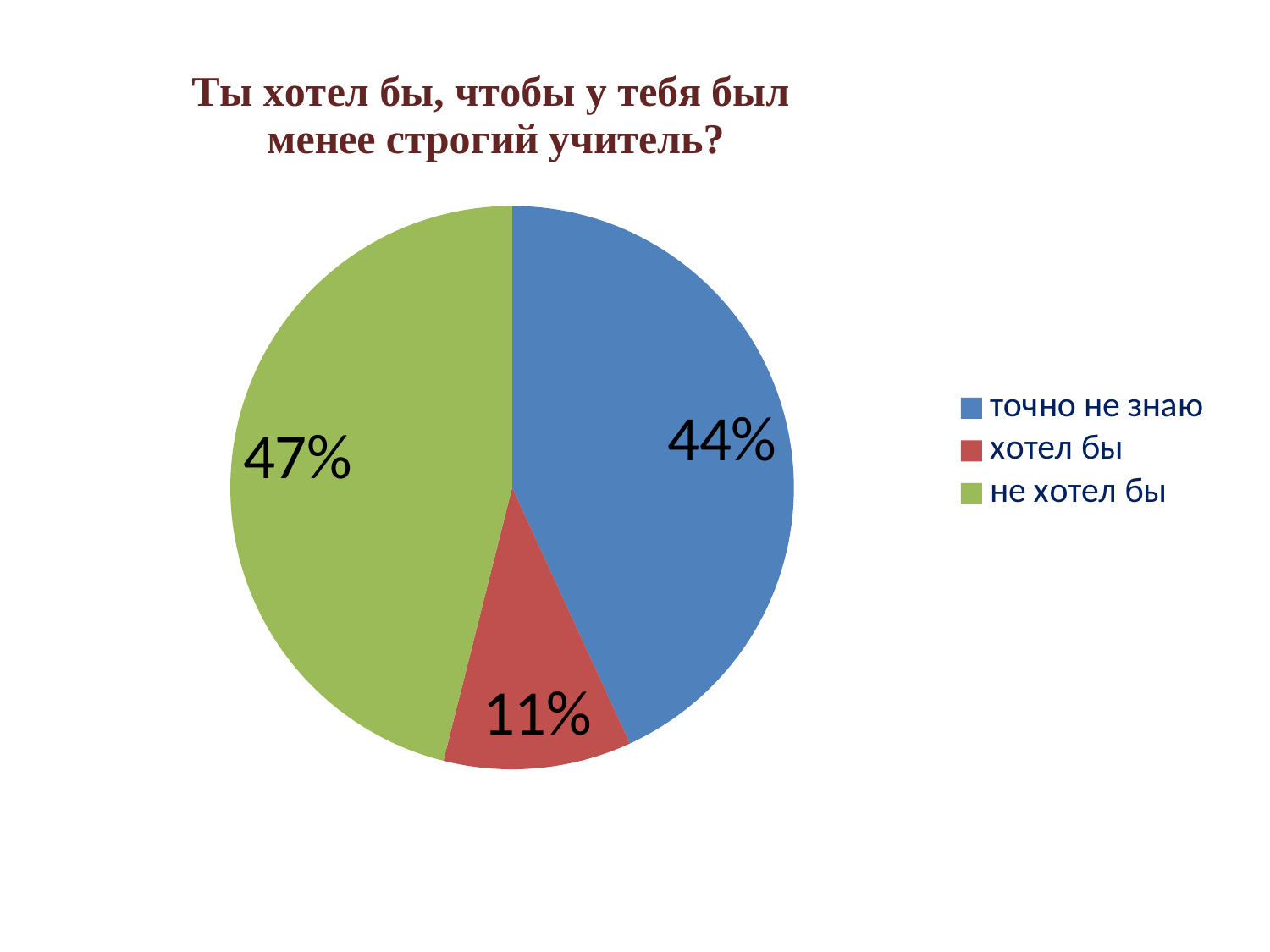
How many slices does the pie chart have? 3 What is the difference in percentage points between "точно не знаю" and "хотел бы"? 33 What share of the pie does "точно не знаю" take? 44% What is the title of the chart? Ты хотел бы, чтобы у тебя был менее строгий учитель? What share of the pie does "не хотел бы" take? 47% What share of the pie does "хотел бы" take? 11% What colour is the slice for "хотел бы"? red Which category has the largest slice of the pie? не хотел бы What is the difference in percentage points between "не хотел бы" and "хотел бы"? 36 Which is larger: the slice for "точно не знаю" or the slice for "хотел бы"? точно не знаю What kind of chart is shown on the slide? pie chart Which category has the smallest slice of the pie? хотел бы